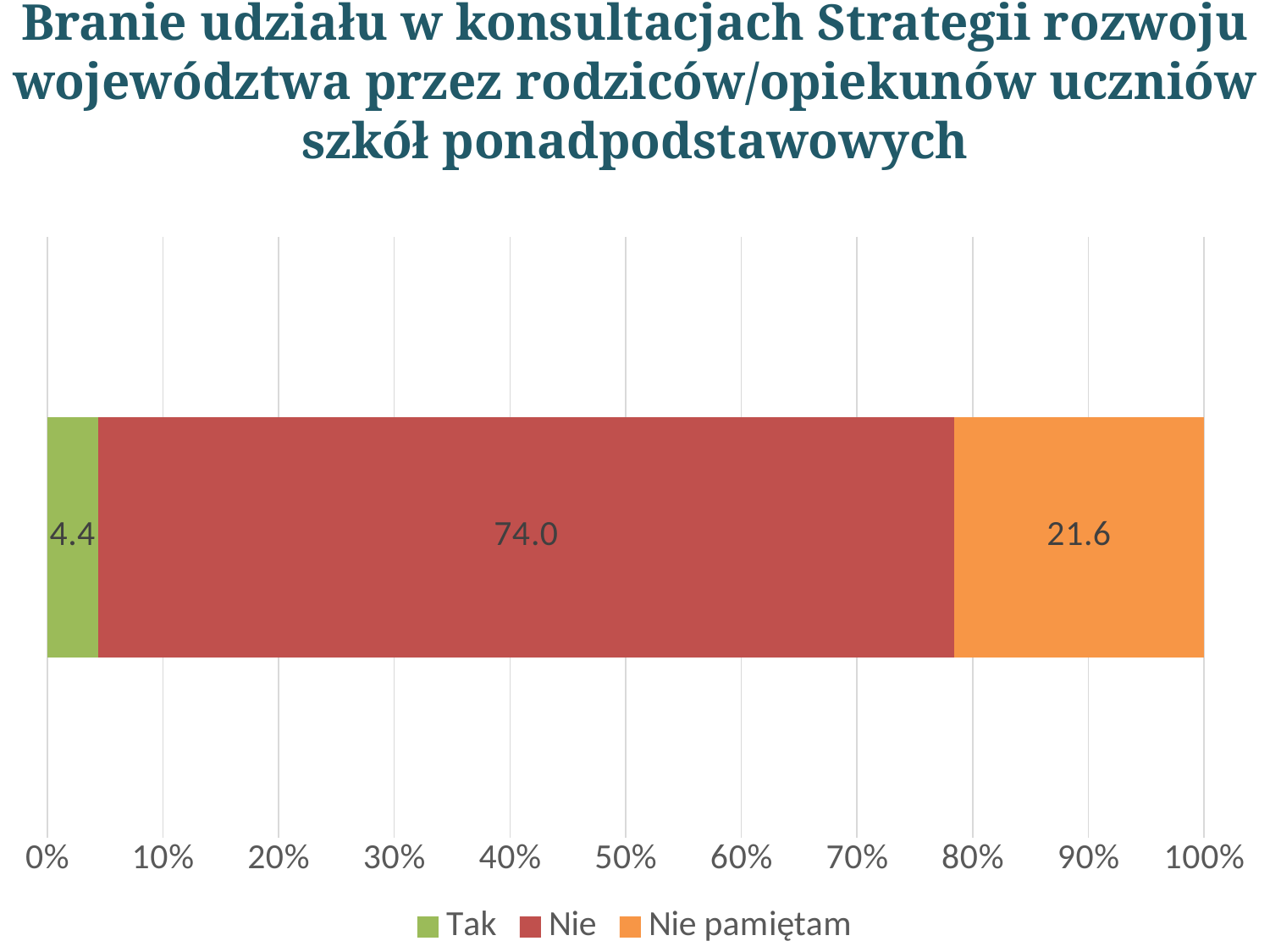
Which is larger, the value for "Nie pamiętam" or the value for "Tak"? Nie pamiętam What kind of chart is shown on the slide? Stacked bar chart Is the value for "Nie" greater or less than 70%? greater What is the value for "Tak"? 4.4 What is the total of the stacked bar? 100.0 Which series has the highest value? Nie How many series does the legend list? 3 What colour represents the "Nie" series? Red Which series has the lowest value? Tak What is the value for "Nie"? 74.0 What is the difference between the values for "Nie" and "Nie pamiętam"? 52.4 What is the value for "Nie pamiętam"? 21.6